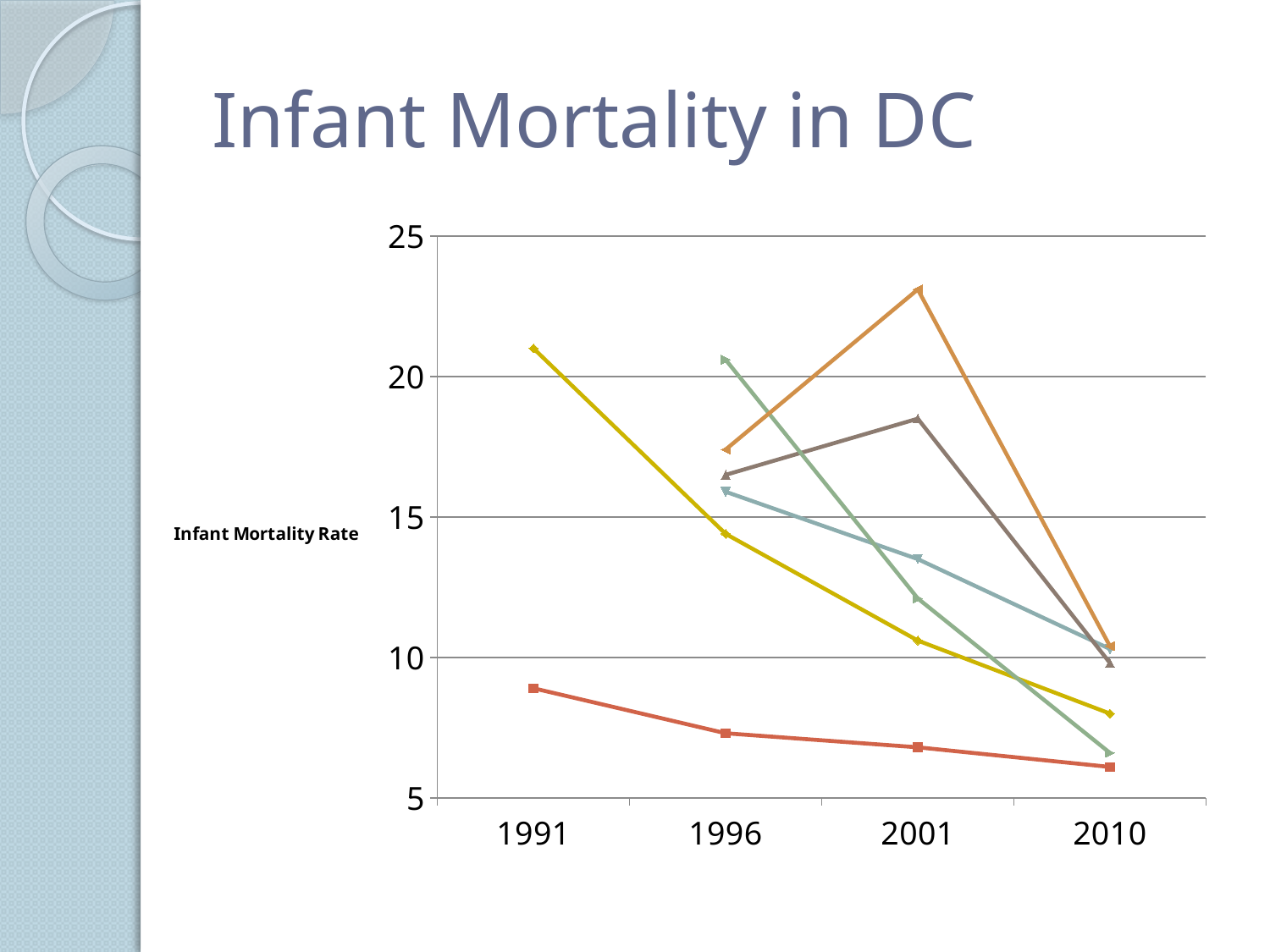
Does the red line rise or fall from 1991 to 2010? fall Is the value of the green line in 2010 greater or less than 10? less What kind of chart is shown on the slide? line chart Is the value of the red line in 1991 greater or less than 10? less Which line has the lowest value in 2010? the red line What is the title of the slide containing the chart? Infant Mortality in DC In which year does the orange line reach its highest value? 2001 What is the label on the vertical axis of the chart? Infant Mortality Rate How many lines are plotted on the chart? 6 Is the value of the yellow line in 1991 greater or less than 20? greater How many years are shown on the x axis of the chart? 4